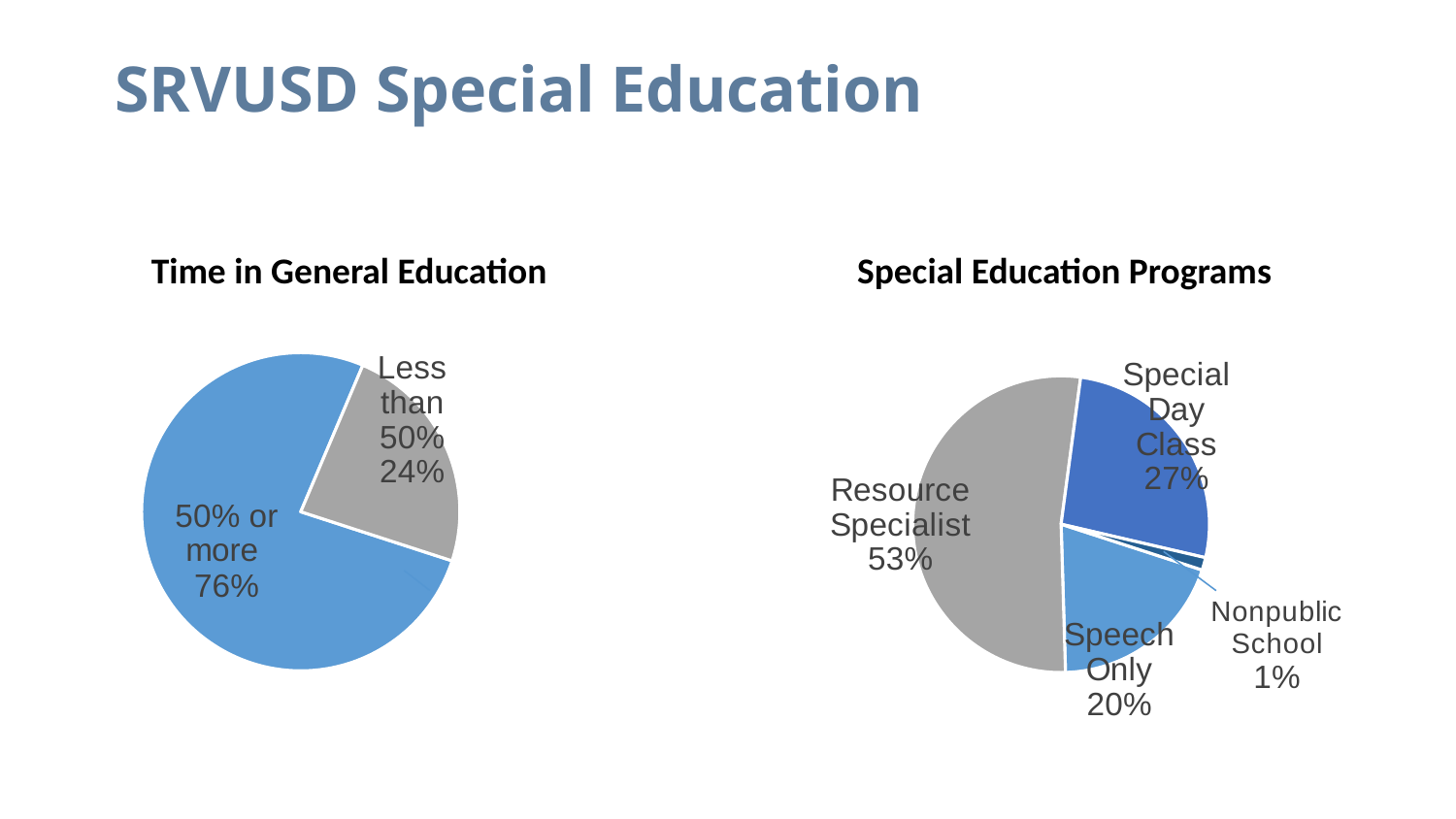
In the 'Special Education Programs' chart, what share is labelled for 'Nonpublic School'? 1% How many slices does the 'Special Education Programs' chart have? 4 In the 'Special Education Programs' chart, which program has the largest slice? Resource Specialist In the 'Special Education Programs' chart, which program has the smallest slice? Nonpublic School In the 'Special Education Programs' chart, which is larger, 'Special Day Class' or 'Speech Only'? Special Day Class In the 'Special Education Programs' chart, what share is labelled for 'Speech Only'? 20% In the 'Time in General Education' chart, what share is labelled for 'Less than 50%'? 24% In the 'Special Education Programs' chart, what share is labelled for 'Resource Specialist'? 53% In the 'Special Education Programs' chart, what is the difference in percentage points between 'Special Day Class' and 'Speech Only'? 7 In the 'Time in General Education' chart, what is the difference in percentage points between '50% or more' and 'Less than 50%'? 52 In the 'Time in General Education' chart, what share is labelled for '50% or more'? 76% What type of chart is the 'Time in General Education' chart? Pie chart